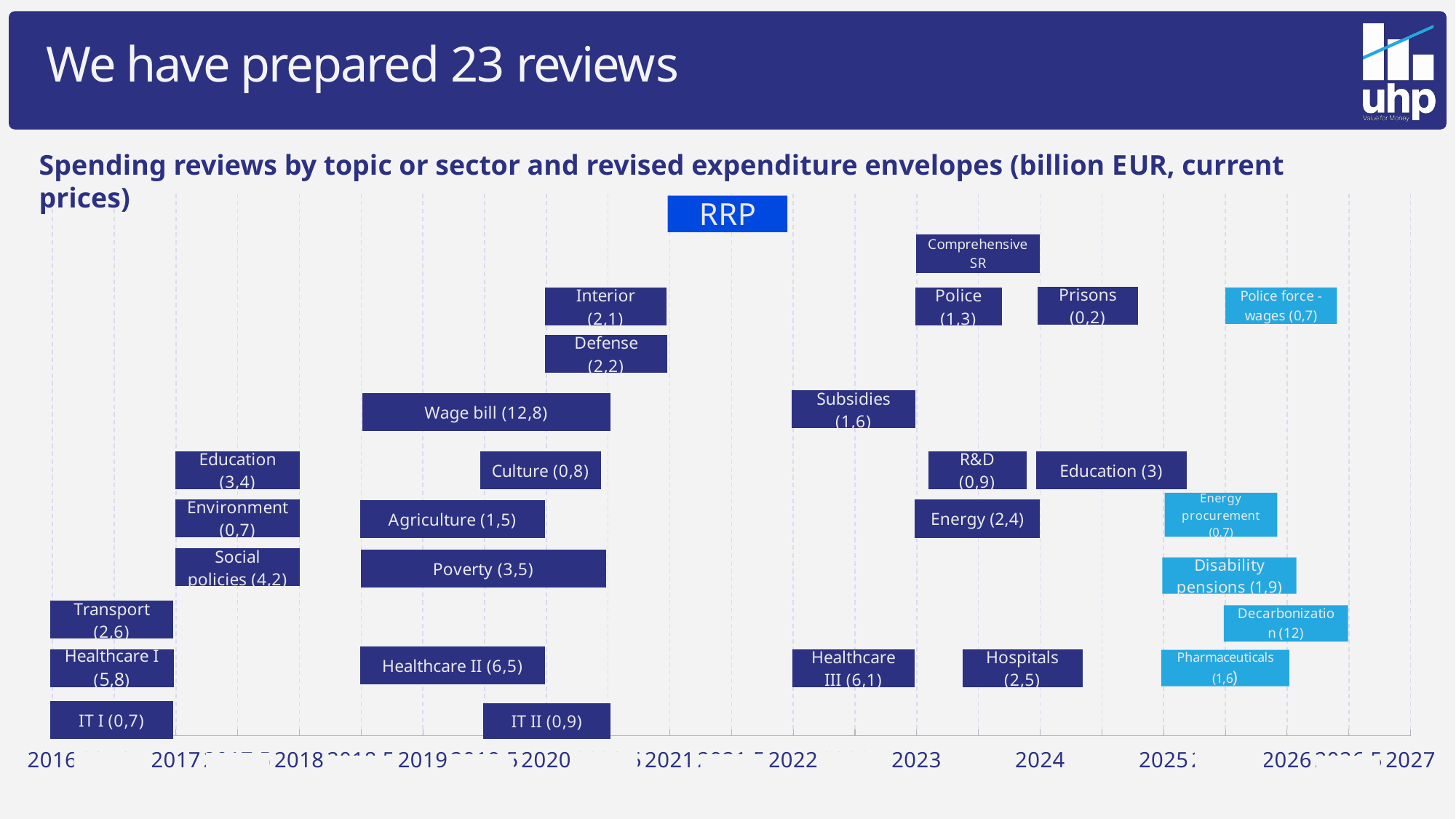
What value is shown for the Decarbonization review? 12 What is the revised expenditure envelope shown for the Wage bill review? 12,8 What is the difference between the values for Social policies and Education (the 2017 review)? 0,8 Which has the larger value, Energy or Hospitals? Hospitals Which has the larger value, Healthcare I or Healthcare II? Healthcare II What is the difference between the values for Healthcare II and Healthcare III? 0,4 Which review has the smallest expenditure envelope printed on the chart? Prisons (0,2) Which review has the largest expenditure envelope printed on the chart? Wage bill (12,8) What value is printed for the Prisons review? 0,2 What label appears in the bright blue box above the 2021 area of the chart? RRP What value is printed for the Healthcare III review? 6,1 What kind of chart is shown on the slide? Gantt (timeline) chart